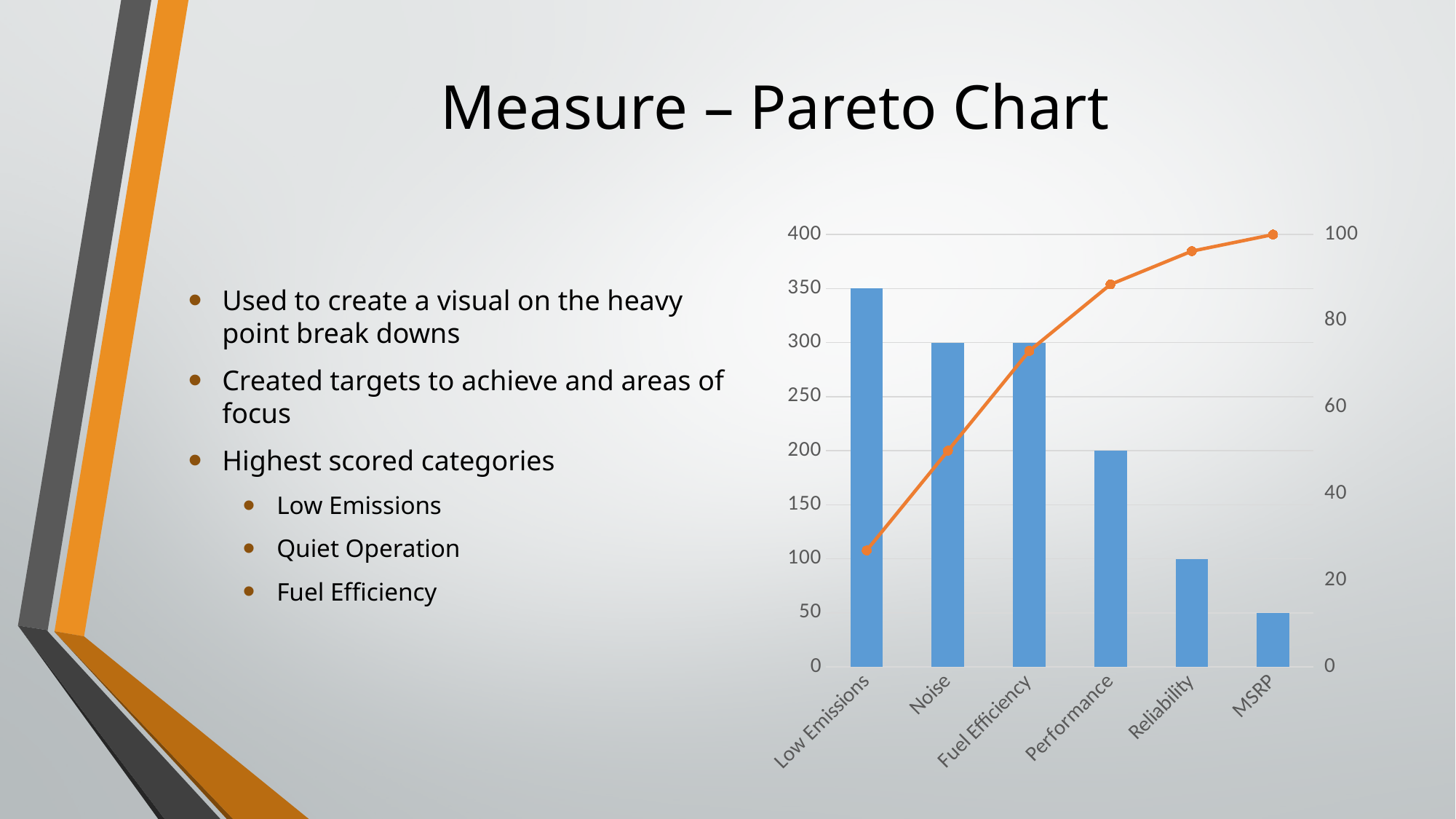
What is the value of the bar for Performance? 200 How many categories are shown on the x axis? 6 Which bar is taller, Performance or Reliability? Performance Which category has the tallest bar? Low Emissions What is the difference between the bar values for Low Emissions and Performance? 150 What is the value of the bar for MSRP? 50 What colour are the bars in the chart? blue Is the value of the line point at Noise (right axis) greater or less than 40? greater Do the bar values rise or fall from left to right along the x axis? fall Which category has the shortest bar? MSRP What value does the line reach at MSRP on the right-hand axis? 100 What is the value of the bar for Low Emissions? 350